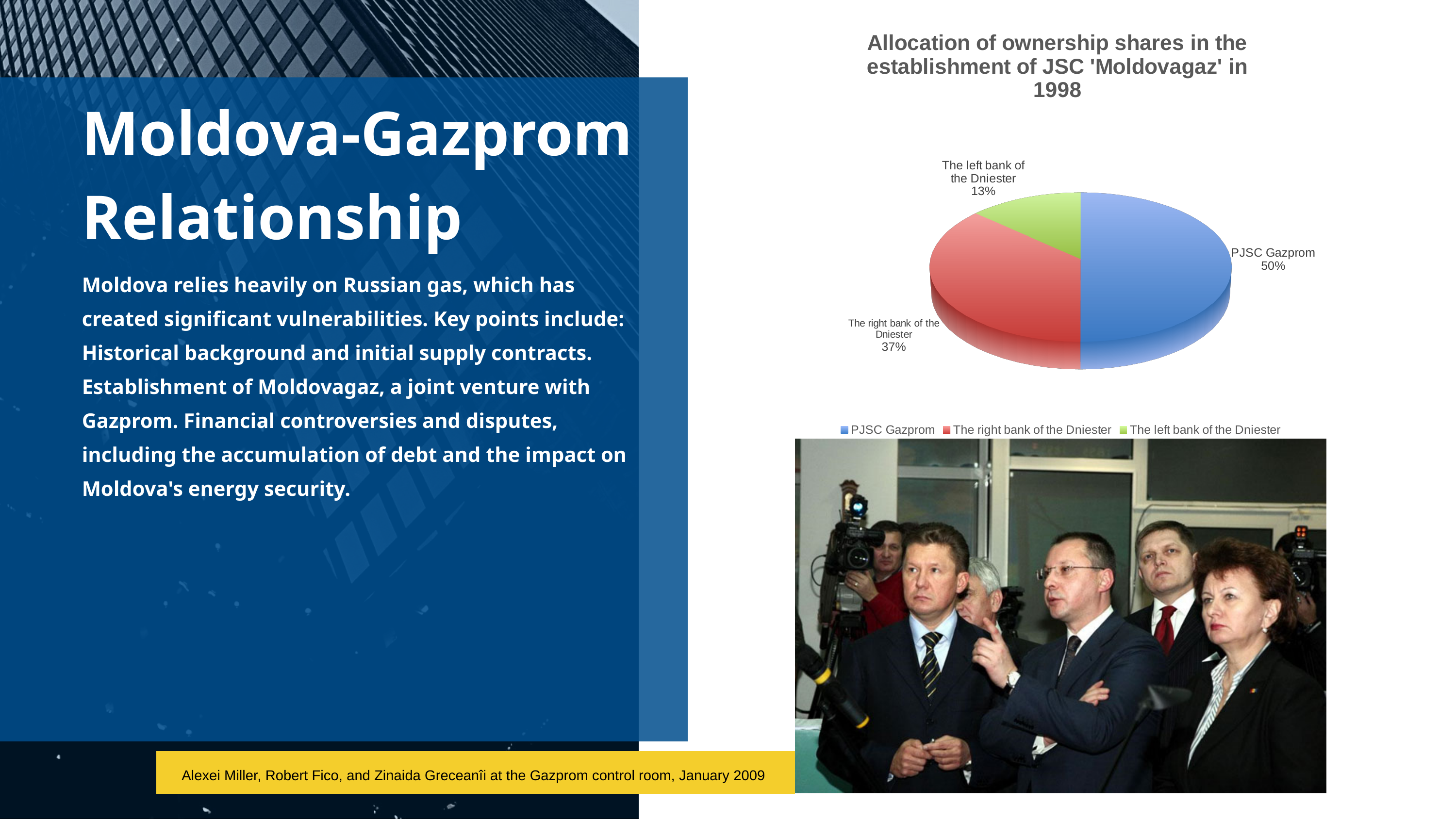
Which has a larger share: the right bank of the Dniester or the left bank of the Dniester? The right bank of the Dniester What type of chart is shown on the slide? Pie chart What share of ownership does the right bank of the Dniester hold? 37% What is the title of the chart? Allocation of ownership shares in the establishment of JSC 'Moldovagaz' in 1998 What is the difference between the shares of PJSC Gazprom and the right bank of the Dniester? 13% What share of ownership does the left bank of the Dniester hold? 13% What colour represents PJSC Gazprom in the pie chart? Blue What is the difference between the shares of the right bank and the left bank of the Dniester? 24% Which shareholder has the largest share in the pie chart? PJSC Gazprom How many slices does the pie chart have? 3 Which shareholder has the smallest share in the pie chart? The left bank of the Dniester What share of ownership does PJSC Gazprom hold in the pie chart? 50%